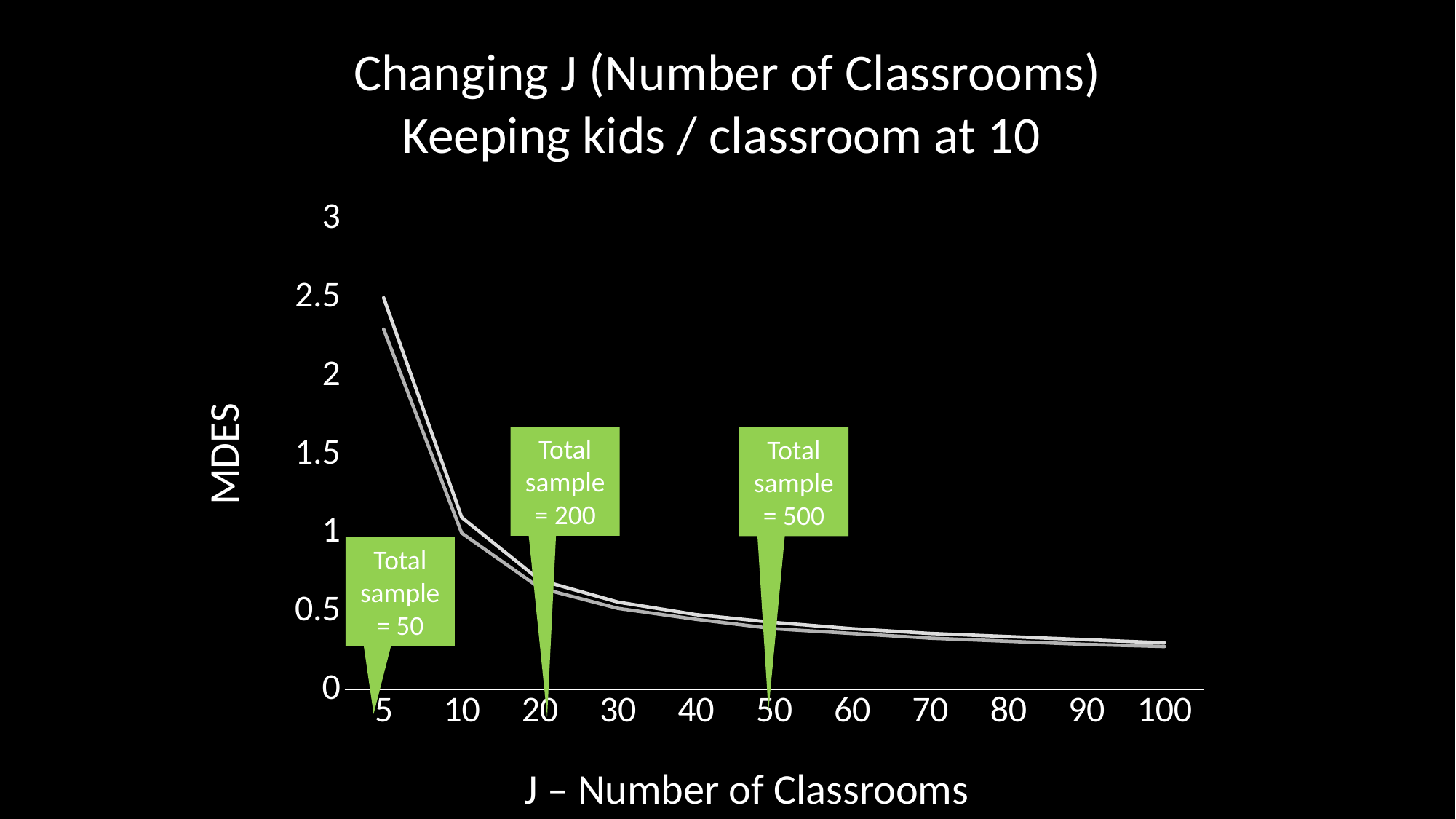
Which has the larger MDES value, J = 10 or J = 50? J = 10 What kind of chart is shown on the slide? line chart At which value of J on the x axis is MDES highest? 5 Do the MDES values rise or fall as J (number of classrooms) increases along the x axis? fall Is the MDES value at J = 5 greater or less than 3? less Is the MDES value at J = 100 greater or less than 0.5? less How many tick values are labelled on the x axis? 11 Is the MDES value at J = 5 greater or less than 2? greater According to the callout at J = 20, what is the total sample? 200 At which value of J on the x axis is MDES lowest? 100 What is the title of the chart? Changing J (Number of Classrooms) Keeping kids / classroom at 10